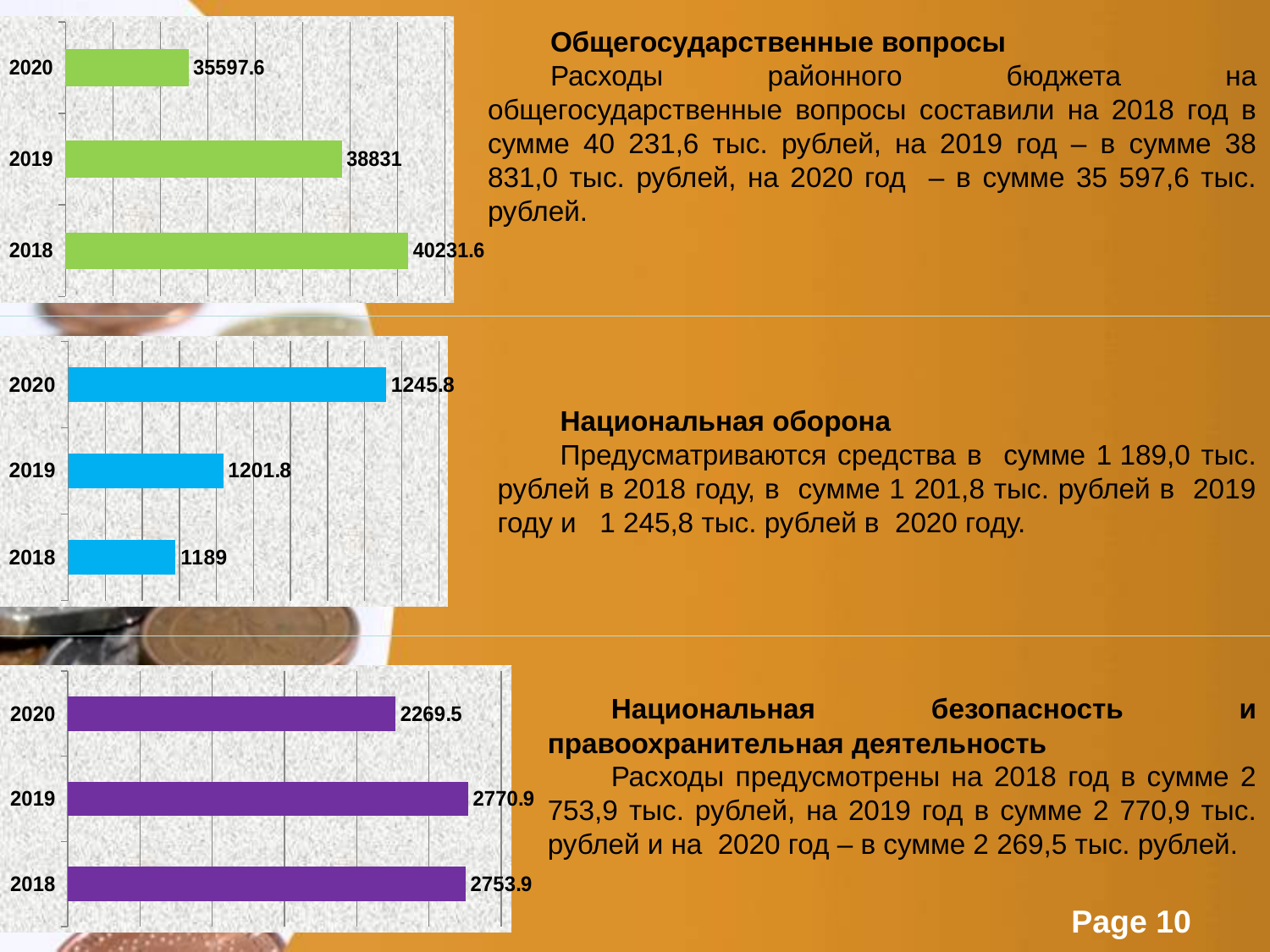
In the bottom chart, what is the difference between the values for 2019 and 2020? 501.4 What type of chart is the middle chart? bar chart In the middle chart, what is the value for 2019? 1201.8 In the top chart, what is the value for 2020? 35597.6 In the top chart, which year has the highest value? 2018 In the top chart, what is the difference between the values for 2018 and 2020? 4634 In the middle chart, which year has the lowest value? 2018 In the top chart, do the values rise or fall from 2018 to 2020? fall In the middle chart, what is the difference between the values for 2020 and 2018? 56.8 How many bars does the bottom chart show? 3 In the bottom chart, what is the value for 2018? 2753.9 In the bottom chart, which is larger, the value for 2019 or the value for 2020? 2019